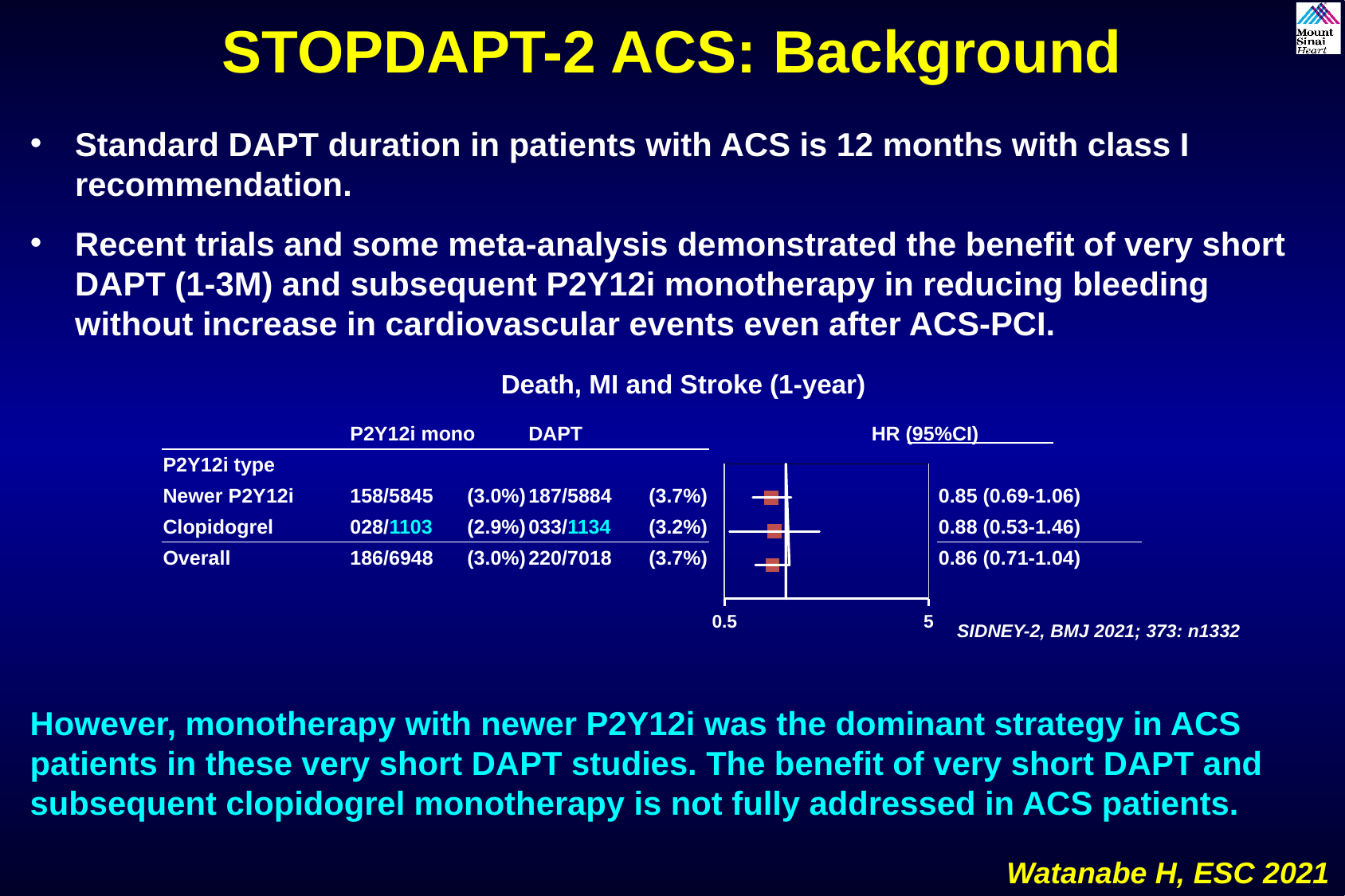
What kind of chart is shown on the slide? Forest plot What is the hazard ratio (95% CI) shown for the Clopidogrel subgroup? 0.88 (0.53-1.46) Is the Overall hazard ratio greater or less than 1? less What is the DAPT event count shown for the Clopidogrel row? 033/1134 What is the event rate for P2Y12i mono in the Newer P2Y12i row? 3.0% How many hazard ratio estimates are plotted in the forest plot? 3 Which subgroup has the higher hazard ratio point estimate, Newer P2Y12i or Clopidogrel? Clopidogrel What is the title of the chart? Death, MI and Stroke (1-year) What is the Overall hazard ratio (95% CI) in the forest plot? 0.86 (0.71-1.04) What is the hazard ratio (95% CI) shown for the Newer P2Y12i subgroup? 0.85 (0.69-1.06) What is the difference between the DAPT and P2Y12i mono event rates in the Overall row? 0.7% Which row has the lowest hazard ratio point estimate? Newer P2Y12i